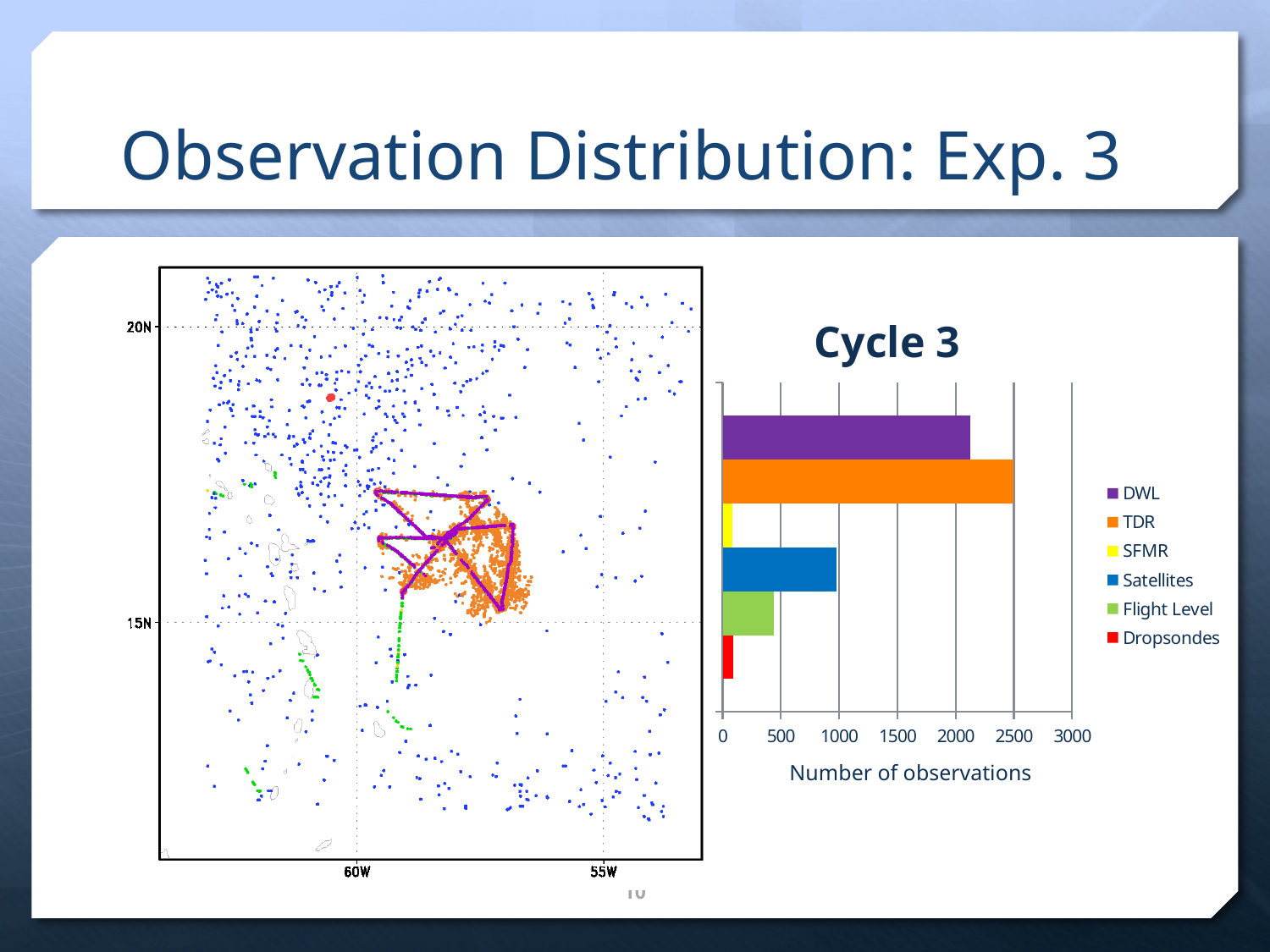
What kind of chart is the 'Cycle 3' chart on the right of the slide? bar chart In the 'Cycle 3' chart, which has more observations, DWL or Satellites? DWL In the 'Cycle 3' chart, is the value for Flight Level greater or less than 500? less In the 'Cycle 3' chart, is the value for TDR greater or less than 2000? greater In the 'Cycle 3' chart, is the value for DWL greater or less than 2000? greater How many series does the legend of the 'Cycle 3' chart list? 6 What is the x-axis label of the 'Cycle 3' chart? Number of observations In the 'Cycle 3' chart, which has more observations, Satellites or Flight Level? Satellites In the 'Cycle 3' chart, which series has the highest number of observations? TDR In the 'Cycle 3' chart, what colour is the TDR bar? orange